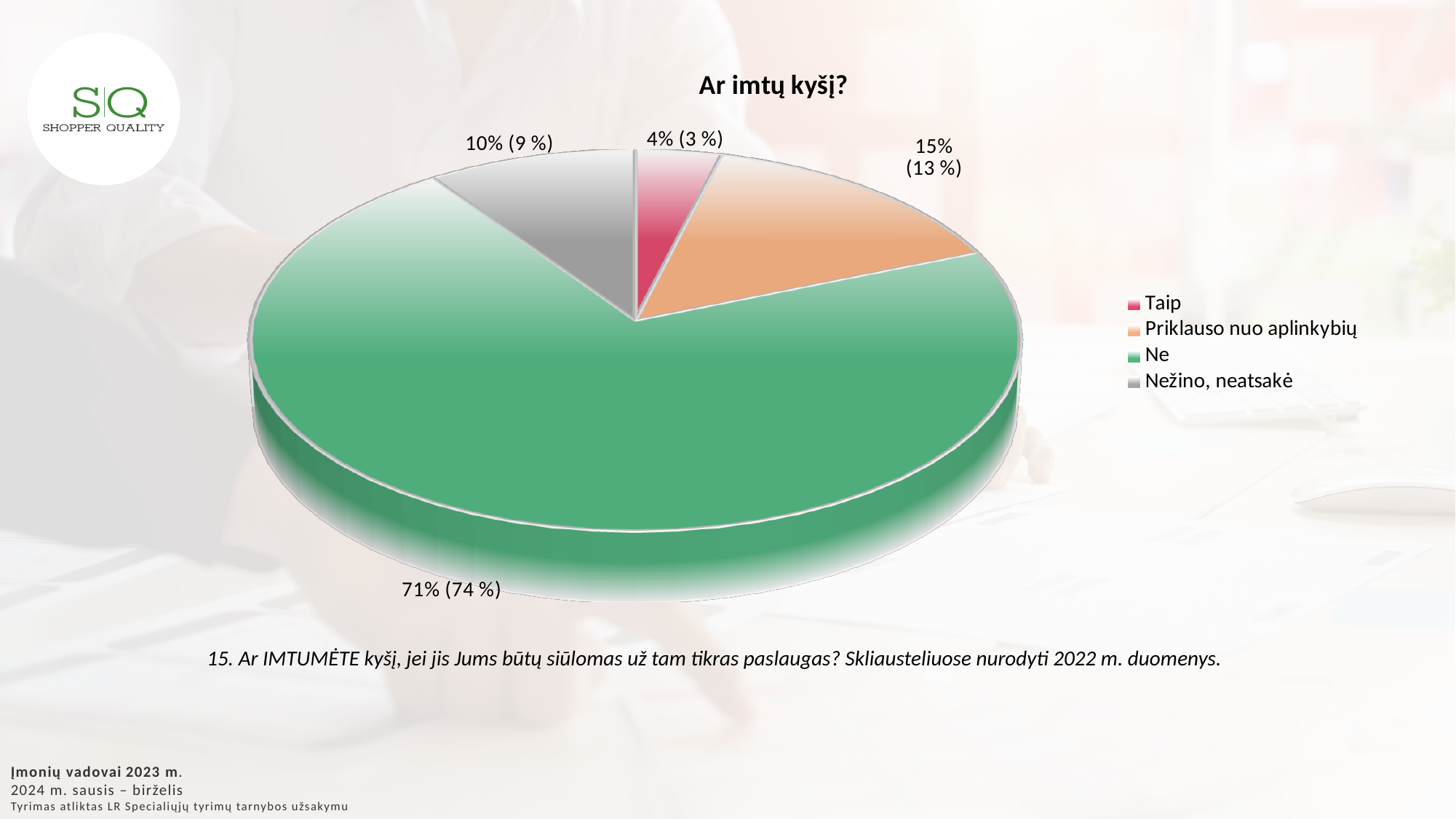
What kind of chart is shown on the slide? pie chart Which category has the largest slice of the pie? Ne What 2022 value is shown in parentheses for the "Ne" slice? 74 % What percentage of the pie is the "Nežino, neatsakė" slice? 10% How many slices does the pie chart have? 4 What is the title of the chart? Ar imtų kyšį? Which slice is larger, "Priklauso nuo aplinkybių" or "Taip"? Priklauso nuo aplinkybių What percentage of the pie is the "Priklauso nuo aplinkybių" slice? 15% What is the difference in percentage points between the "Priklauso nuo aplinkybių" slice and the "Nežino, neatsakė" slice? 5 What percentage of the pie is the "Taip" slice? 4% Which category has the smallest slice of the pie? Taip What percentage of the pie is the "Ne" slice? 71%